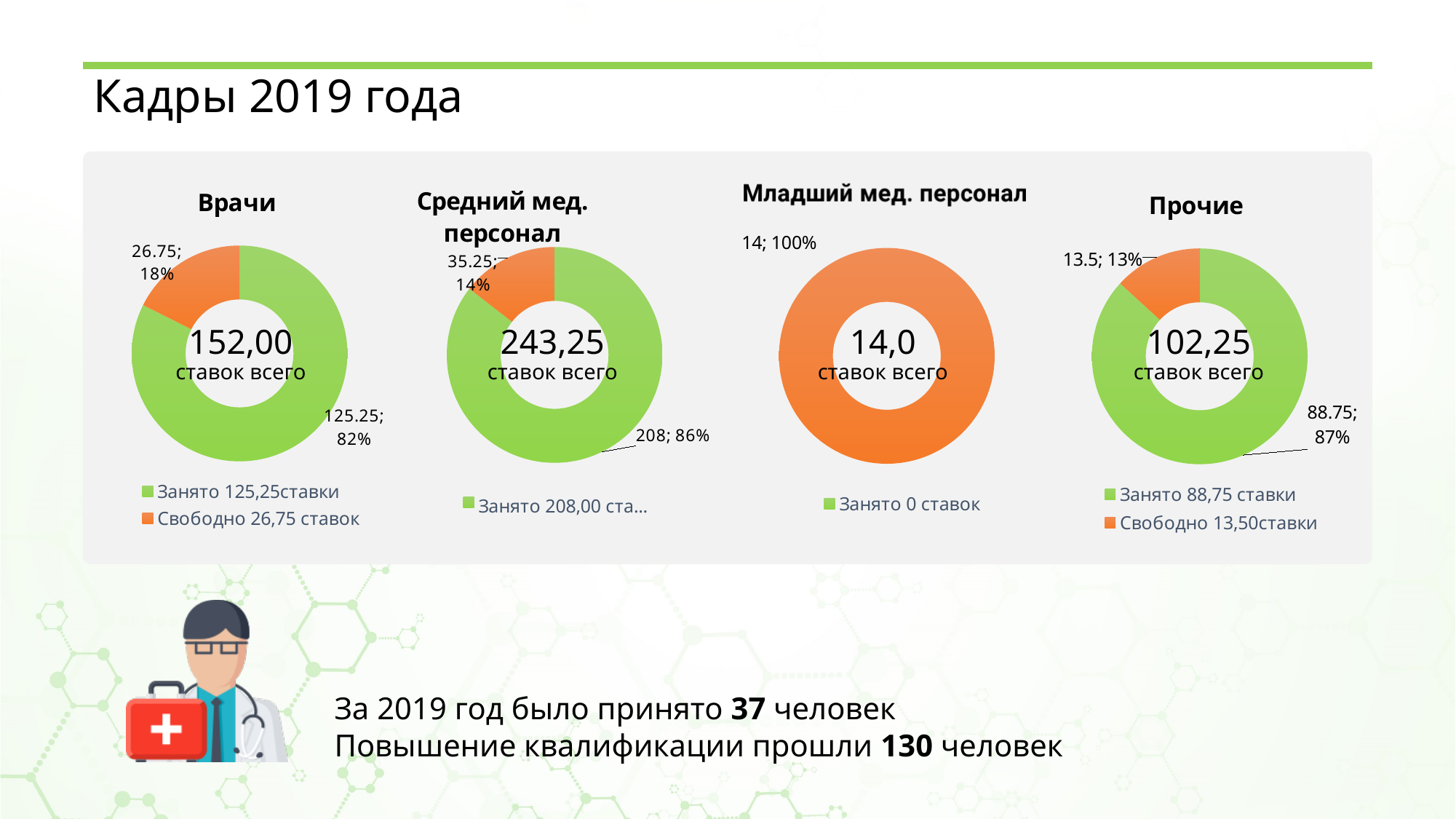
What kind of chart is used for the "Врачи" chart? Donut (pie) chart In the "Врачи" chart, what value is shown for the "Свободно" slice? 26.75 What total number of positions (ставок всего) is shown in the centre of the "Средний мед. персонал" chart? 243,25 In the "Младший мед. персонал" chart, what value and percentage are labelled on the single slice? 14; 100% In the "Прочие" chart, which slice is larger, "Занято" or "Свободно"? Занято How many entries does the legend of the "Врачи" chart list? 2 In the "Средний мед. персонал" chart, what is the difference between the two slice values, 208 and 35.25? 172.75 In the "Врачи" chart, what share of the total does the "Занято" slice represent? 82% How many slices does the "Младший мед. персонал" chart show? 1 Which of the four charts has the largest total number of positions shown in its centre? Средний мед. персонал In the "Прочие" chart, what value is shown for the "Свободно" slice? 13.5 In the "Средний мед. персонал" chart, what percentage is labelled on the green slice? 86%